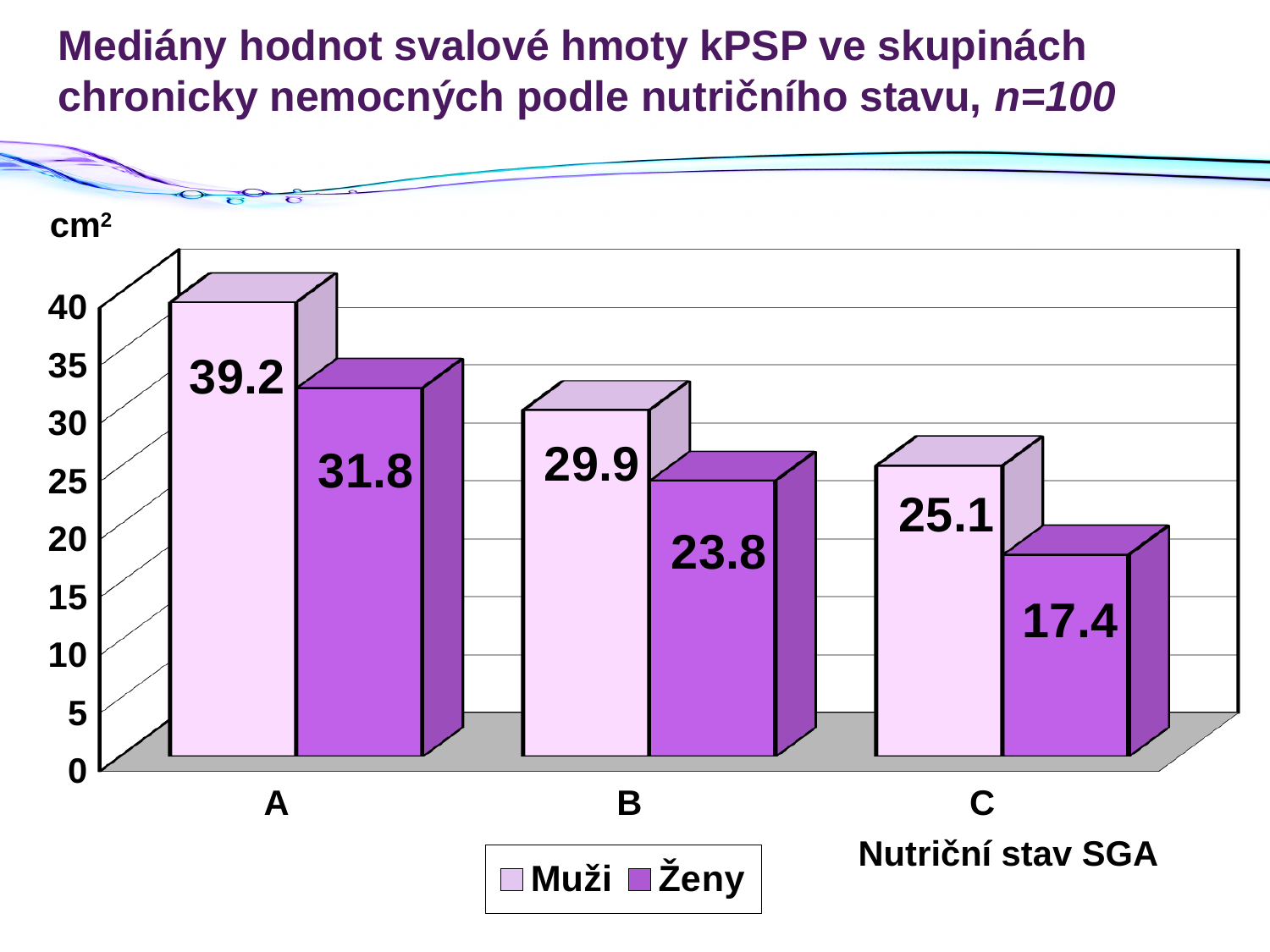
Do the Muži values rise or fall from group A to group C? fall How many series does the legend list? 2 How many groups are shown on the x axis? 3 What is the value for Ženy in group C? 17.4 What is the value for Muži in group A? 39.2 What is the difference between the Muži and Ženy values in group A? 7.4 What is the difference between the Muži values in group B and group C? 4.8 What kind of chart is shown? bar chart Which group has the lowest value for Ženy? C Which is larger: the Ženy value in group A or the Muži value in group B? Ženy in group A Which group has the highest value for Muži? A What is the value for Ženy in group B? 23.8